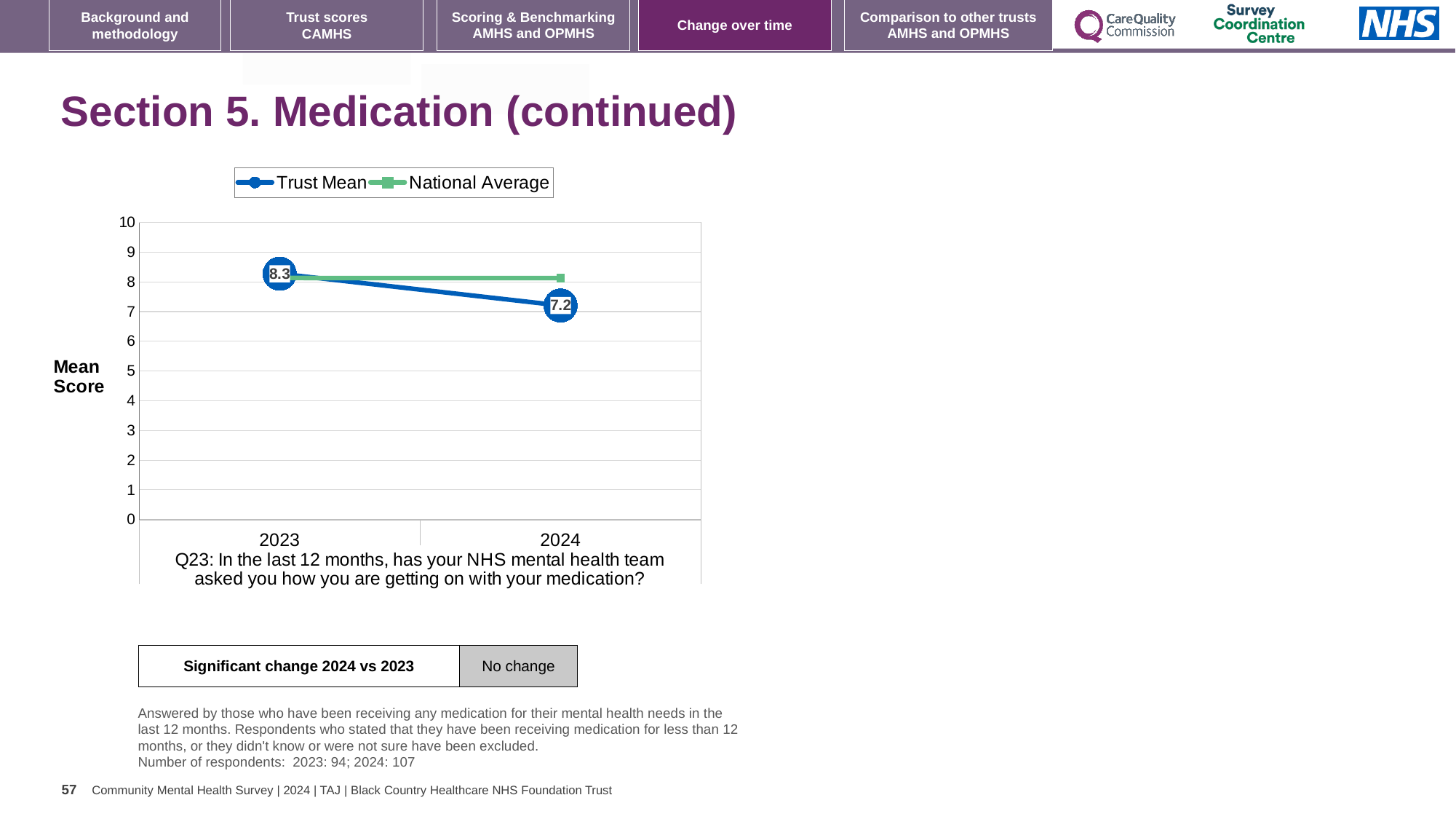
How many years are shown on the x axis? 2 In 2024, which is higher: the Trust Mean or the National Average? National Average Does the Trust Mean rise or fall from 2023 to 2024? Fall What is the Trust Mean score for 2024? 7.2 In which year is the Trust Mean score highest? 2023 In which year is the Trust Mean score lowest? 2024 What kind of chart is shown on the slide? Line chart Is the Trust Mean value for 2024 greater or less than 8? less What is the difference between the Trust Mean score in 2023 and in 2024? 1.1 What is the Trust Mean score for 2023? 8.3 Is the National Average value for 2024 greater or less than 7? greater How many series does the legend list? 2